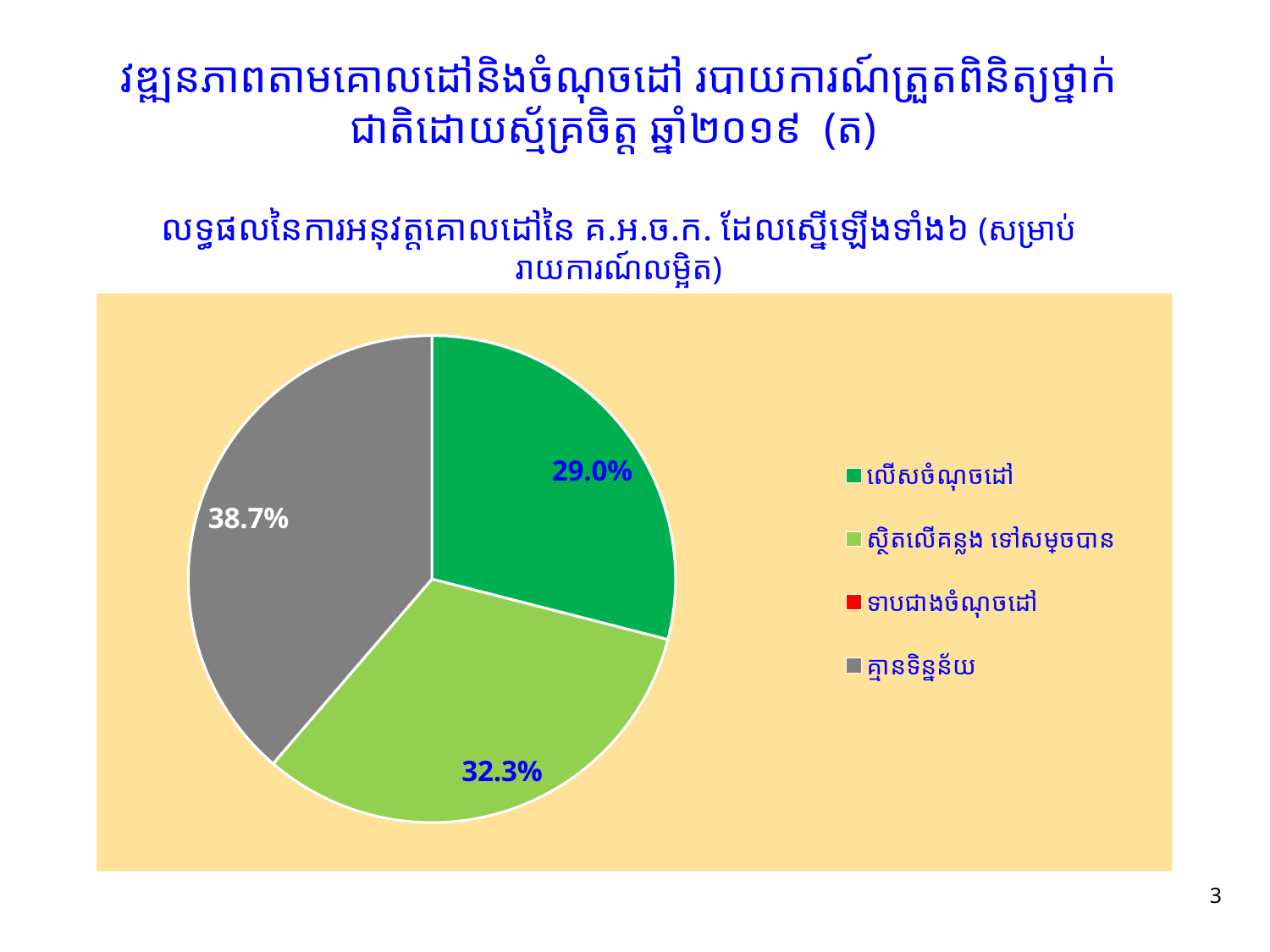
How many categories does the legend list? 4 What colour is the legend marker for ទាបជាងចំណុចដៅ? red What share of the pie is labelled for the dark green slice (លើសចំណុចដៅ)? 29.0% Which is larger: the share for ស្ថិតលើគន្លង ទៅសម្រេចបាន or the share for លើសចំណុចដៅ? ស្ថិតលើគន្លង ទៅសម្រេចបាន Which legend category has the largest slice of the pie? គ្មានទិន្នន័យ What is the difference in percentage points between the light green slice (32.3%) and the dark green slice (29.0%)? 3.3 Of the slices with printed labels, which category has the smallest share? លើសចំណុចដៅ What share of the pie is labelled for the grey slice (គ្មានទិន្នន័យ)? 38.7% What kind of chart is shown on the slide? pie chart How many slices with printed percentage labels are visible in the pie? 3 What is the difference in percentage points between the grey slice (38.7%) and the dark green slice (29.0%)? 9.7 What share of the pie is labelled for the light green slice (ស្ថិតលើគន្លង ទៅសម្រេចបាន)? 32.3%